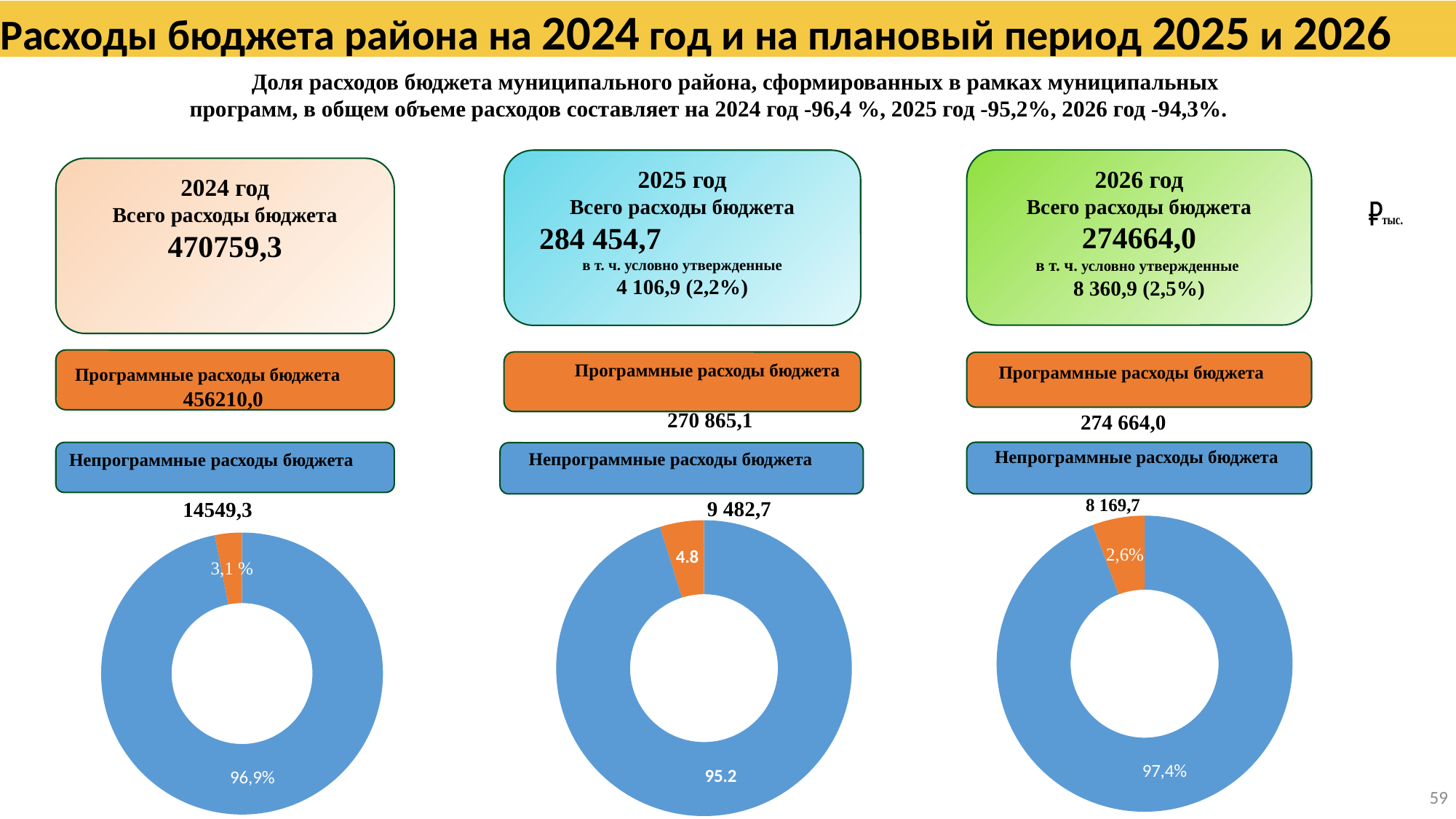
In the right (2026) donut chart, what share is shown for the blue slice? 97,4% In the left (2024) donut chart, what share is shown for the large blue slice? 96,9% How many slices does the left (2024) donut chart have? 2 In the right (2026) donut chart, which slice is larger, the blue one or the orange one? Blue What kind of chart is shown under the 2024 column at the bottom of the slide? Donut (pie) chart How many donut charts are shown on the slide? 3 In the middle (2025) donut chart, what value is printed on the blue slice? 95.2